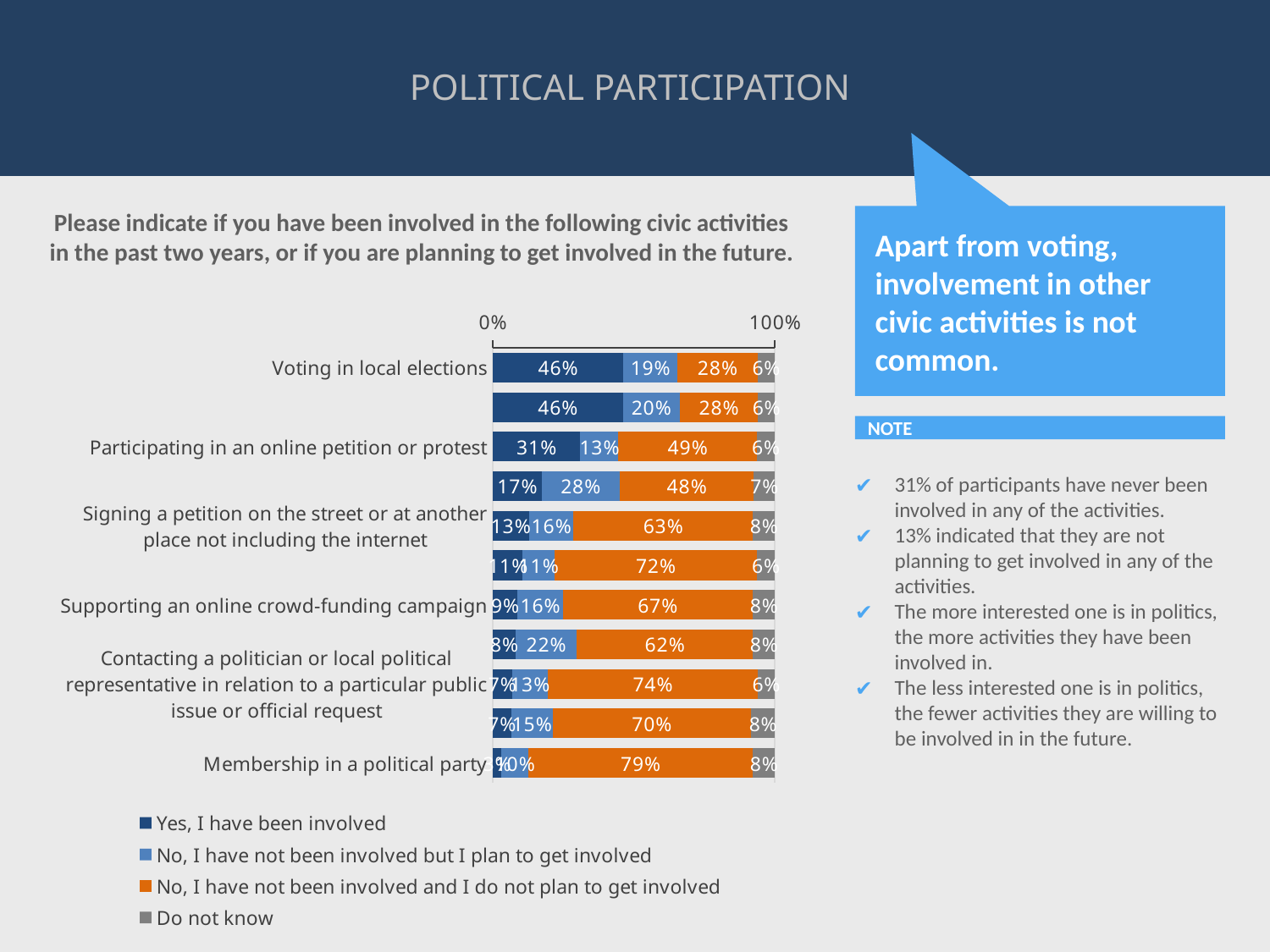
Which has the larger "No, I have not been involved and I do not plan to get involved" share: Membership in a political party or Contacting a politician or local political representative? Membership in a political party What is the "Do not know" value for Voting in local elections? 6% For Participating in an online petition or protest, what share said "No, I have not been involved and I do not plan to get involved"? 49% For Supporting an online crowd-funding campaign, what share said "No, I have not been involved but I plan to get involved"? 16% What kind of chart is shown on the slide? Stacked bar chart What is the "No, I have not been involved and I do not plan to get involved" value for Contacting a politician or local political representative? 74% What percentage said "Yes, I have been involved" for Signing a petition on the street or at another place not including the internet? 13% What percentage of respondents said "Yes, I have been involved" for Voting in local elections? 46% How many series does the legend list? 4 Among the labelled activities, which has the highest "Yes, I have been involved" share? Voting in local elections How many percentage points higher is the "Yes, I have been involved" share for Voting in local elections than for Participating in an online petition or protest? 15 percentage points What is the "No, I have not been involved and I do not plan to get involved" value for Membership in a political party? 79%